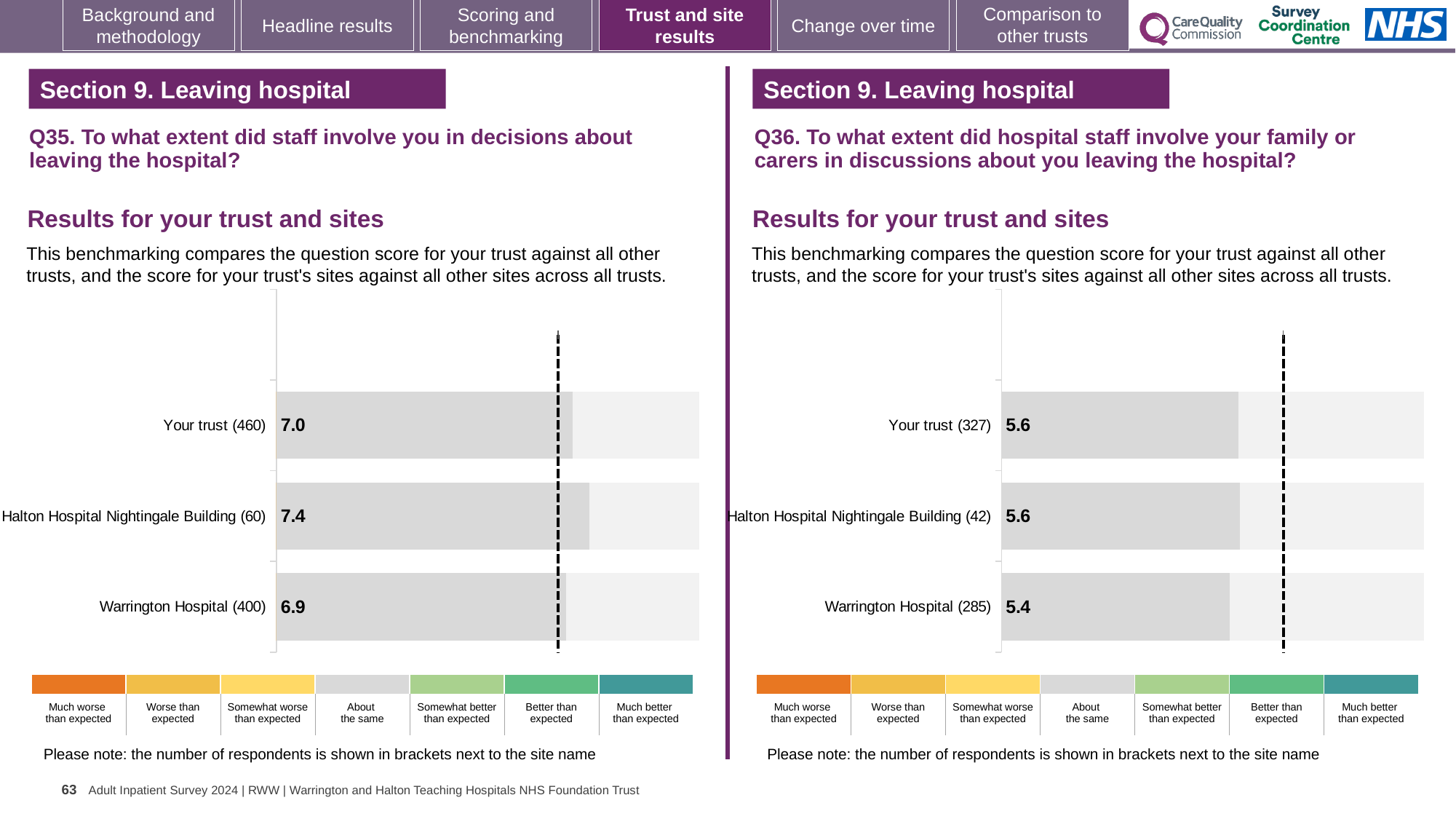
In the Q36 chart on the right, which site or trust has the lowest score? Warrington Hospital In the Q35 chart on the left, what is the score for Halton Hospital Nightingale Building? 7.4 What type of chart is used in the Q36 chart on the right? Bar chart In the Q35 chart on the left, what is the score for Your trust? 7.0 In the Q35 chart on the left, which site or trust has the highest score? Halton Hospital Nightingale Building In the Q35 chart on the left, which site or trust has the lowest score? Warrington Hospital In the Q35 chart on the left, what is the difference between the scores for Halton Hospital Nightingale Building and Warrington Hospital? 0.5 How many bars are plotted in the Q35 chart on the left? 3 In the Q36 chart on the right, what is the score for Your trust? 5.6 In the Q36 chart on the right, what is the score for Warrington Hospital? 5.4 In the Q35 chart on the left, what is the score for Warrington Hospital? 6.9 In the Q36 chart on the right, what is the difference between the scores for Your trust and Warrington Hospital? 0.2